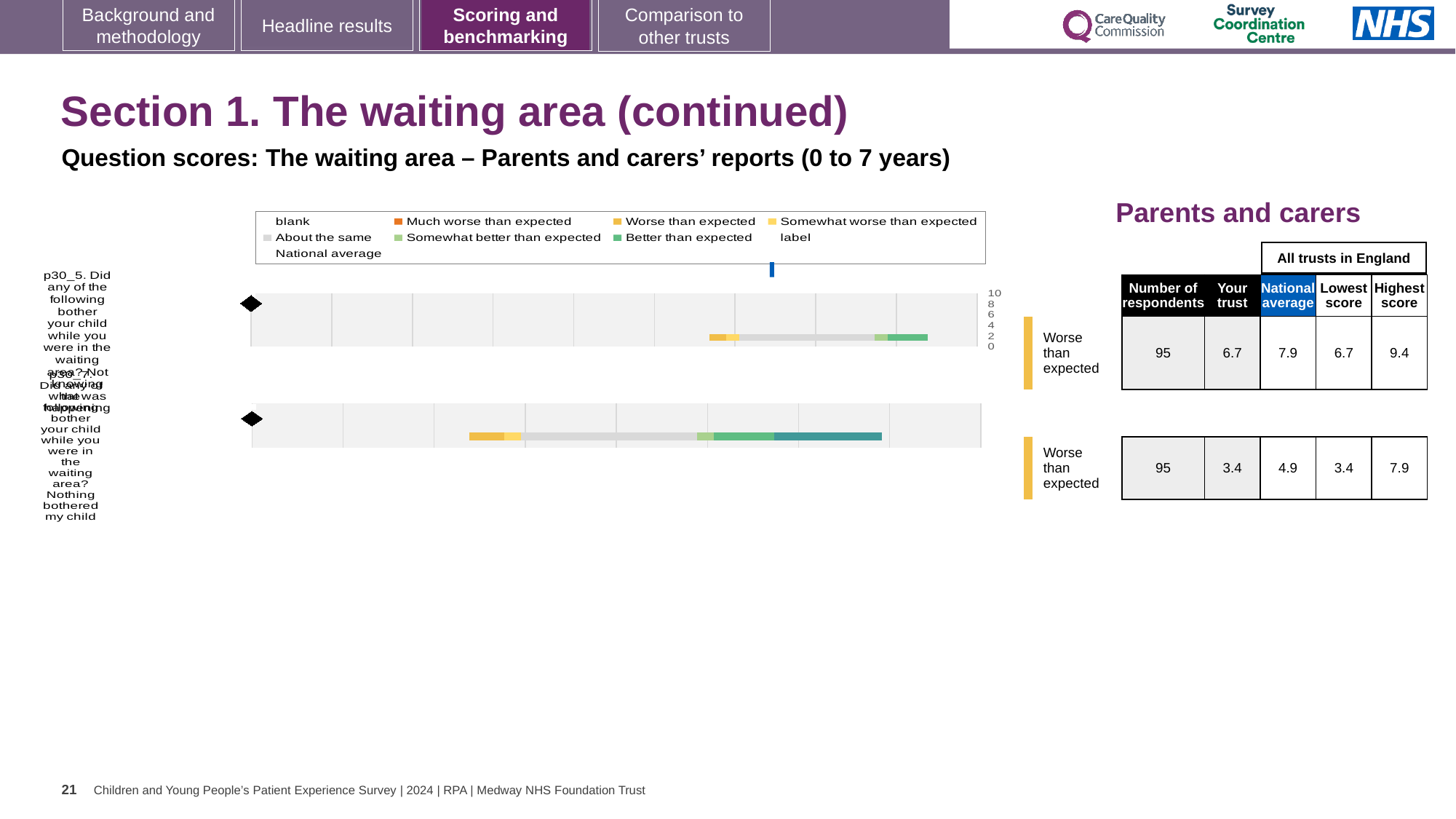
In the table, what is the highest score for the bottom question (p30_7)? 7.9 How many entries does the chart legend list? 9 In the table, what is the 'Your trust' score for the top question (p30_5)? 6.7 What benchmark rating label is shown beside both question rows? Worse than expected How many question bars are plotted in the chart? 2 In the table, what is the national average for the bottom question (p30_7)? 4.9 What is the difference between the highest and lowest scores for the top question (p30_5)? 2.7 What kind of chart is shown on the slide? bar chart What is the difference between the national average and the 'Your trust' score for the top question (p30_5)? 1.2 What is the heading above the table on the right of the slide? Parents and carers Which question has the larger 'Your trust' score, the top one (p30_5) or the bottom one (p30_7)? the top one (p30_5) How many respondents are listed for the top question (p30_5)? 95